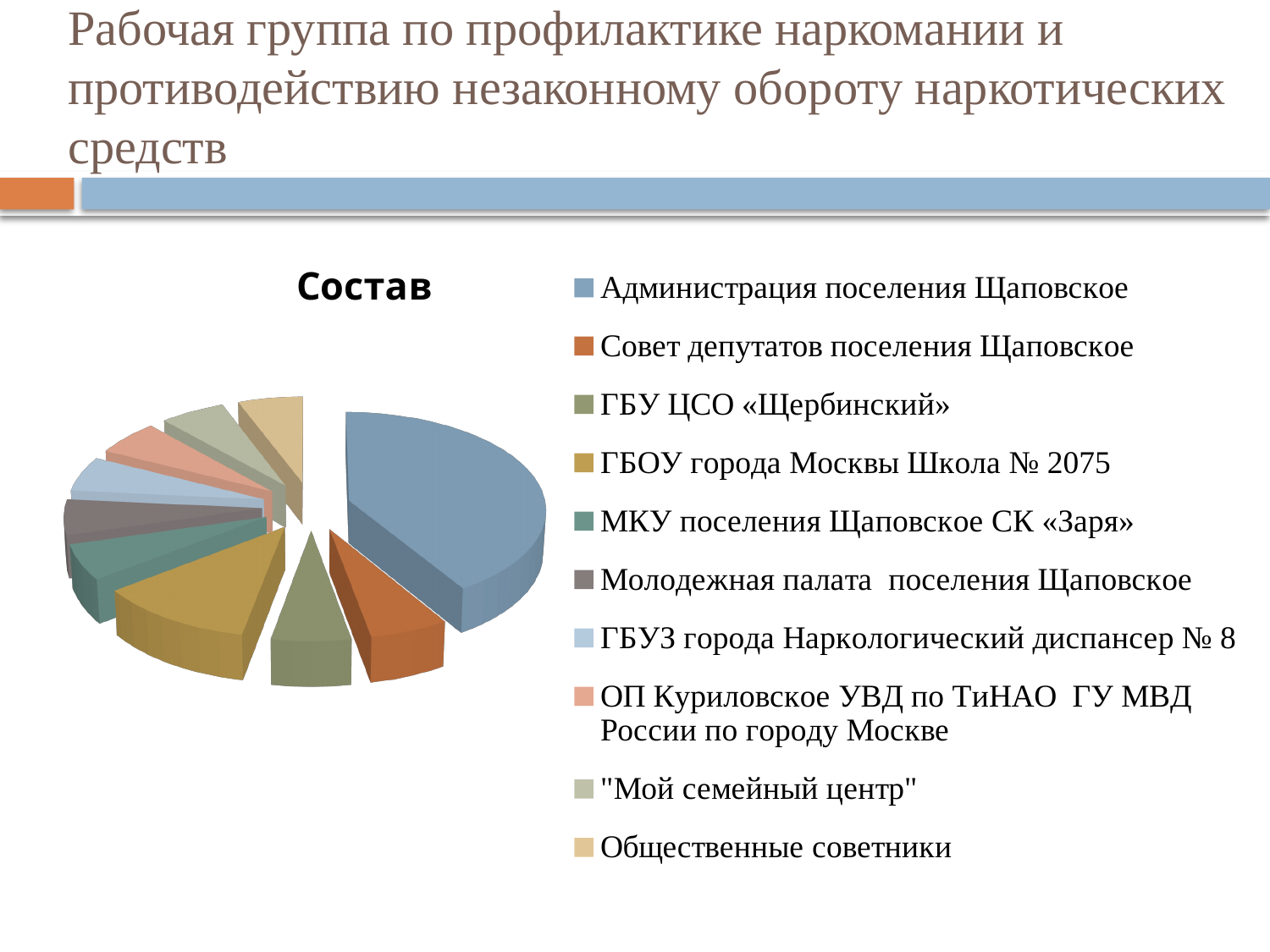
Which category is shown in blue in the legend? Администрация поселения Щаповское Which slice is larger: Администрация поселения Щаповское or Совет депутатов поселения Щаповское? Администрация поселения Щаповское How many entries does the chart legend list? 10 How many categories (slices) does the pie chart have? 10 Which slice is larger: ГБОУ города Москвы Школа № 2075 or Молодежная палата поселения Щаповское? ГБОУ города Москвы Школа № 2075 Which slice is larger: Администрация поселения Щаповское or ГБУЗ города Наркологический диспансер № 8? Администрация поселения Щаповское What is the title of the chart? Состав Which category has the largest slice of the pie? Администрация поселения Щаповское Which legend entry is listed last? Общественные советники What kind of chart is shown on the slide? pie chart